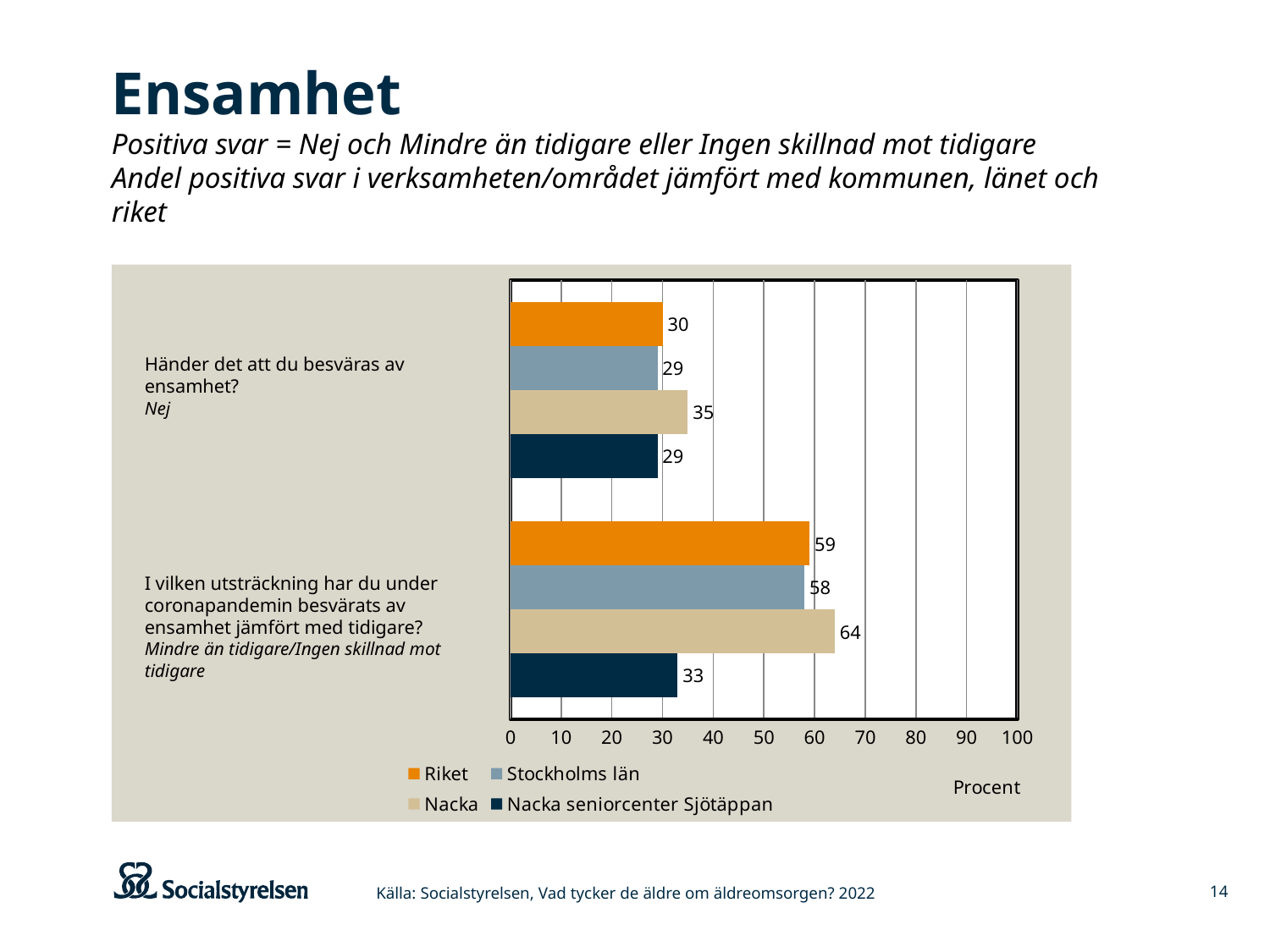
Which series has the lowest value on the question "I vilken utsträckning har du under coronapandemin besvärats av ensamhet jämfört med tidigare?"? Nacka seniorcenter Sjötäppan What kind of chart is shown on the slide? Bar chart Which series has the highest value on the question "I vilken utsträckning har du under coronapandemin besvärats av ensamhet jämfört med tidigare?"? Nacka What unit label is shown under the x axis of the chart? Procent How many question categories are shown on the chart? 2 How many series does the legend list? 4 What is the value for Stockholms län on the question "Händer det att du besväras av ensamhet?"? 29 What is the value for Riket on the question "I vilken utsträckning har du under coronapandemin besvärats av ensamhet jämfört med tidigare?"? 59 Which is larger on the question "Händer det att du besväras av ensamhet?": the value for Nacka or the value for Riket? Nacka What is the difference between Nacka and Nacka seniorcenter Sjötäppan on the question "I vilken utsträckning har du under coronapandemin besvärats av ensamhet jämfört med tidigare?"? 31 What is the value for Nacka on the question "Händer det att du besväras av ensamhet?"? 35 What is the value for Nacka seniorcenter Sjötäppan on the question "I vilken utsträckning har du under coronapandemin besvärats av ensamhet jämfört med tidigare?"? 33